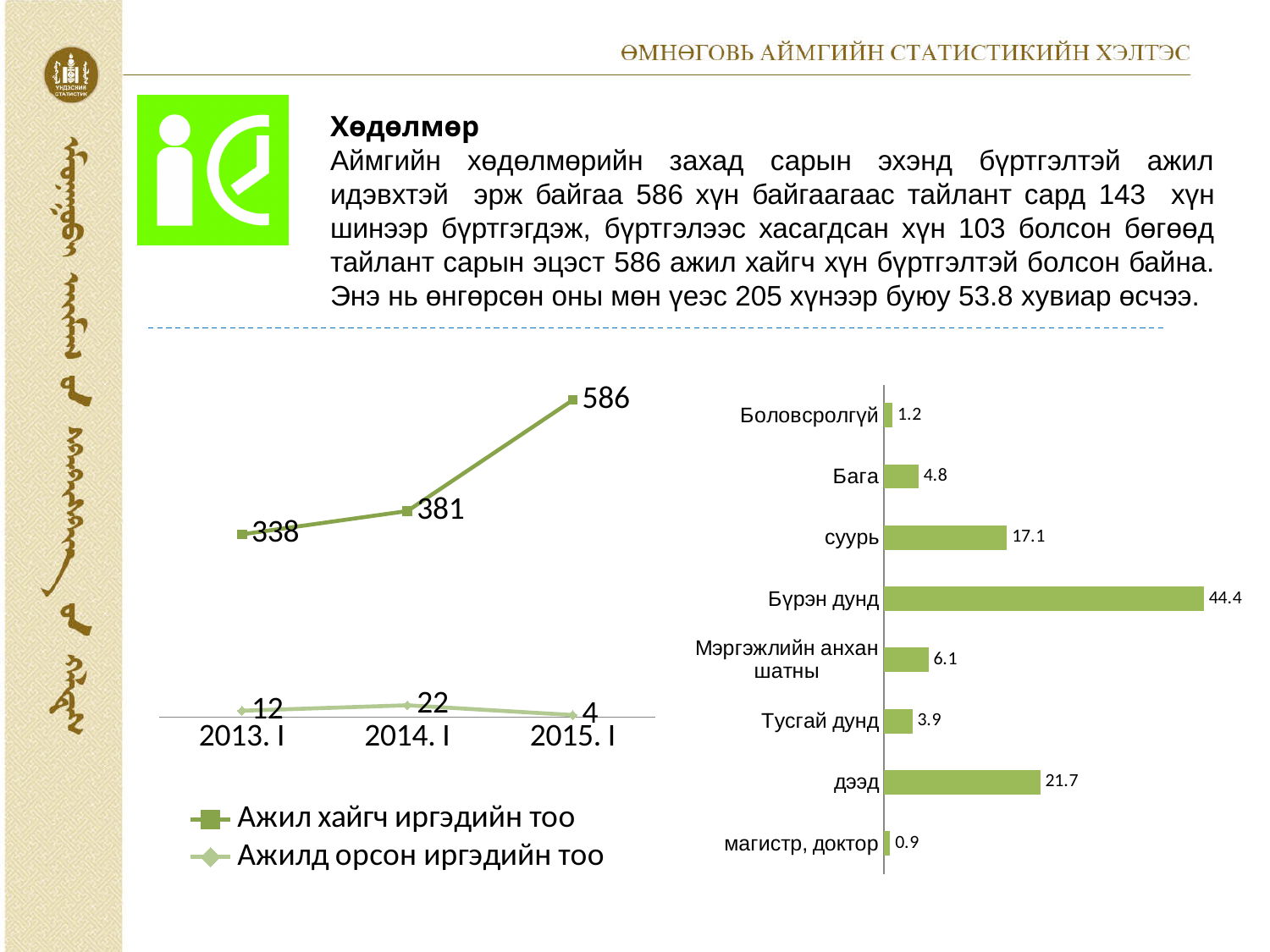
In the line chart on the left, in which period is Ажилд орсон иргэдийн тоо lowest? 2015. I In the line chart on the left, how many series does the legend list? 2 In the line chart on the left, what is the value of Ажилд орсон иргэдийн тоо for 2014. I? 22 In the bar chart on the right, which category has the lowest value? магистр, доктор In the bar chart on the right, what is the value for Бүрэн дунд? 44.4 In the bar chart on the right, which is larger: дээд or суурь? дээд In the bar chart on the right, which category has the highest value? Бүрэн дунд In the line chart on the left, what is the value of Ажил хайгч иргэдийн тоо for 2015. I? 586 What kind of chart is on the right side of the slide? bar chart In the line chart on the left, does Ажил хайгч иргэдийн тоо rise or fall from 2013. I to 2015. I? rise In the line chart on the left, how many periods are shown on the x axis? 3 In the line chart on the left, what is the difference between Ажил хайгч иргэдийн тоо in 2015. I and 2014. I? 205